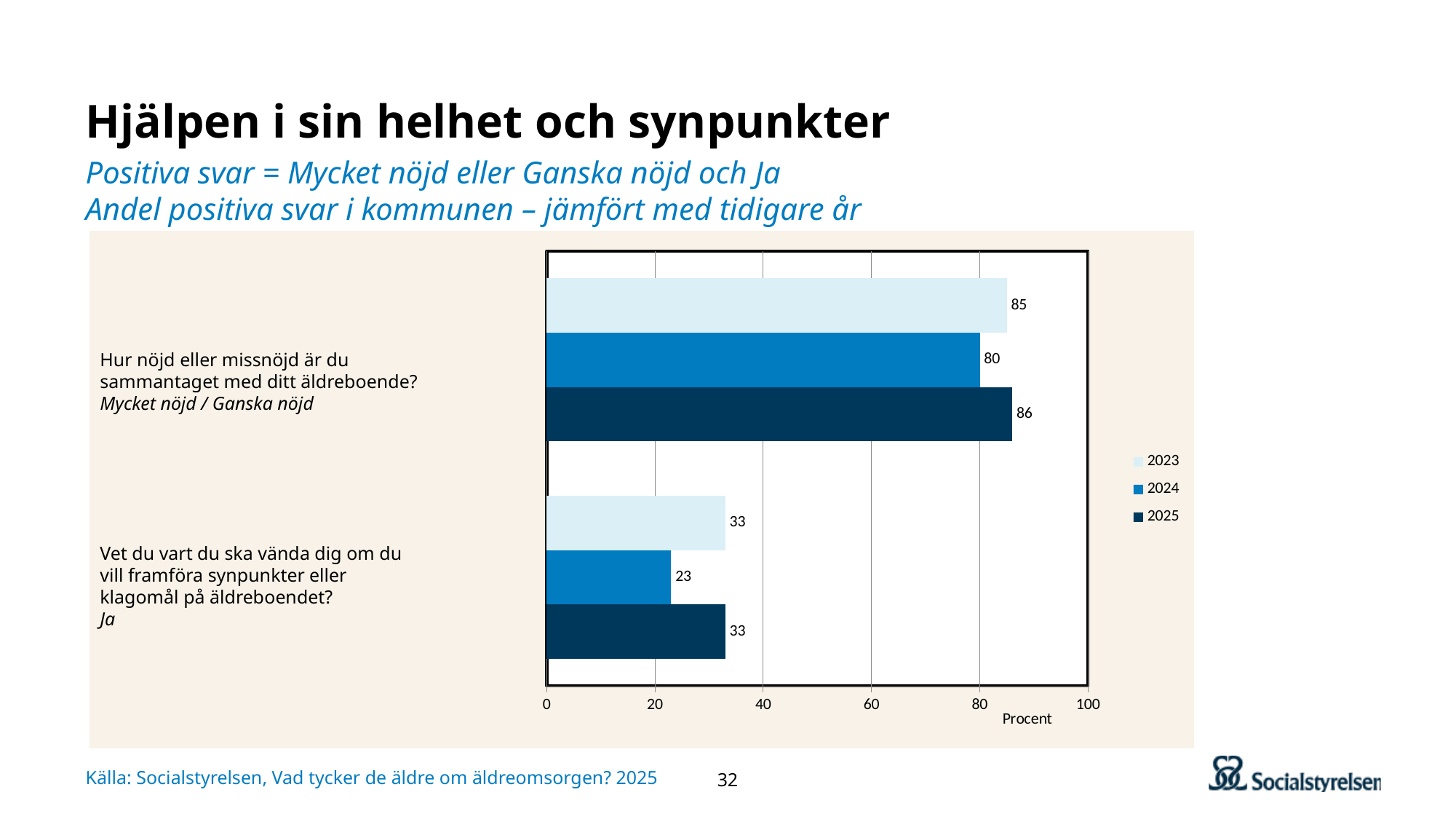
What is the label on the x axis of the chart? Procent What kind of chart is shown on the slide? Bar chart What is the 2023 value for 'Hur nöjd eller missnöjd är du sammantaget med ditt äldreboende?' 85 Which is larger: the 2025 value for 'Hur nöjd eller missnöjd är du sammantaget med ditt äldreboende?' or the 2025 value for 'Vet du vart du ska vända dig om du vill framföra synpunkter eller klagomål på äldreboendet?' Hur nöjd eller missnöjd är du sammantaget med ditt äldreboende? What is the difference between the 2023 and 2024 values for 'Vet du vart du ska vända dig om du vill framföra synpunkter eller klagomål på äldreboendet?' 10 What is the 2025 value for 'Hur nöjd eller missnöjd är du sammantaget med ditt äldreboende?' 86 How many question categories are shown on the chart? 2 Which year has the lowest value for 'Vet du vart du ska vända dig om du vill framföra synpunkter eller klagomål på äldreboendet?' 2024 What is the 2024 value for 'Vet du vart du ska vända dig om du vill framföra synpunkter eller klagomål på äldreboendet?' 23 What is the difference between the 2025 and 2024 values for 'Hur nöjd eller missnöjd är du sammantaget med ditt äldreboende?' 6 How many series does the legend list? 3 Which year has the highest value for 'Hur nöjd eller missnöjd är du sammantaget med ditt äldreboende?' 2025